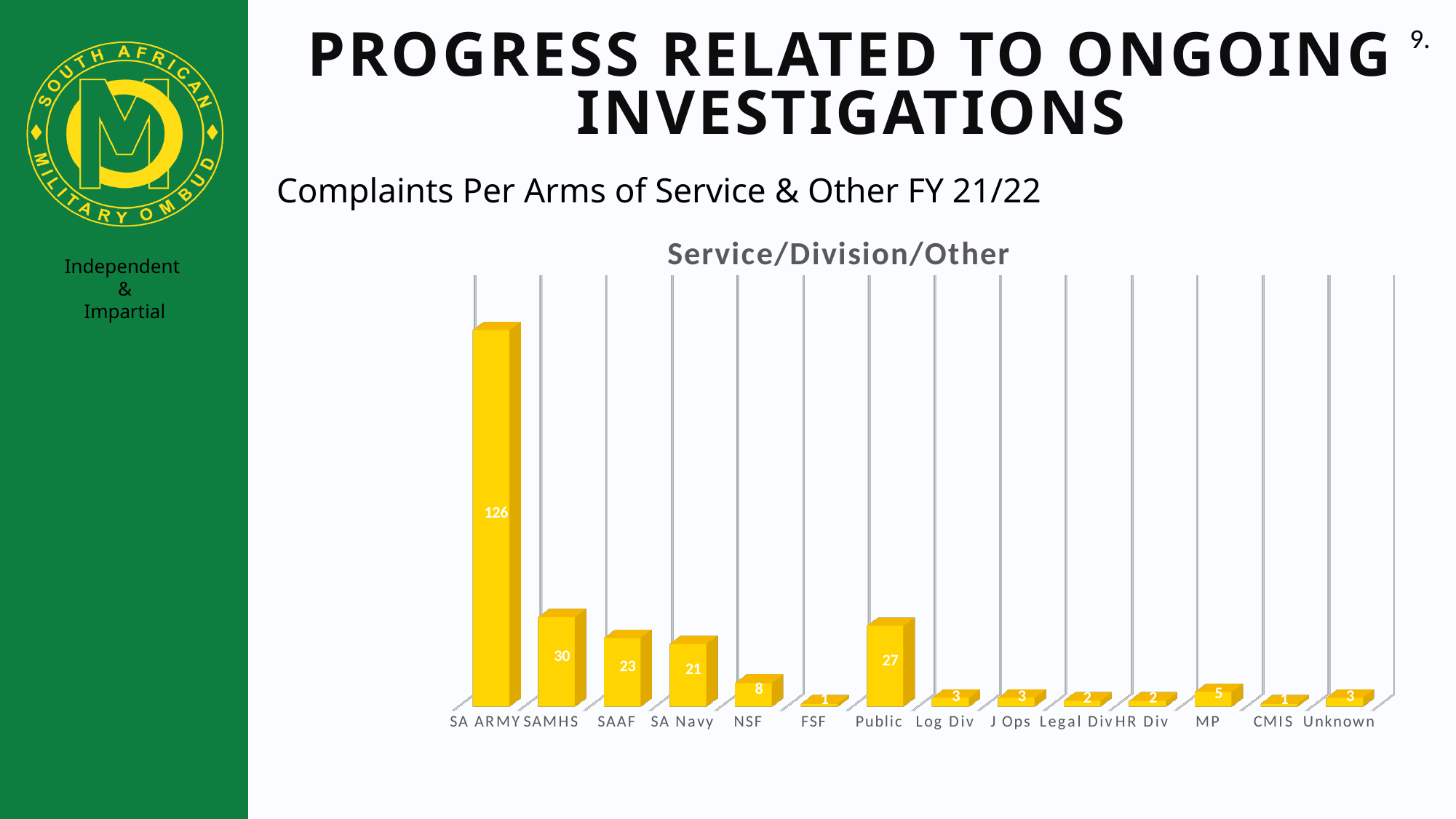
Which is larger, the value for SAMHS or the value for Public? SAMHS What kind of chart is shown on the slide? Bar chart What is the value for SA ARMY? 126 What is the title of the chart? Service/Division/Other What is the difference between the values for SA ARMY and Public? 99 How many categories are shown on the x axis? 14 Which category has the highest value? SA ARMY Which is larger, the value for NSF or the value for MP? NSF What is the value for SA Navy? 21 What is the value for MP? 5 What is the value for Public? 27 What is the difference between the values for SAMHS and SAAF? 7